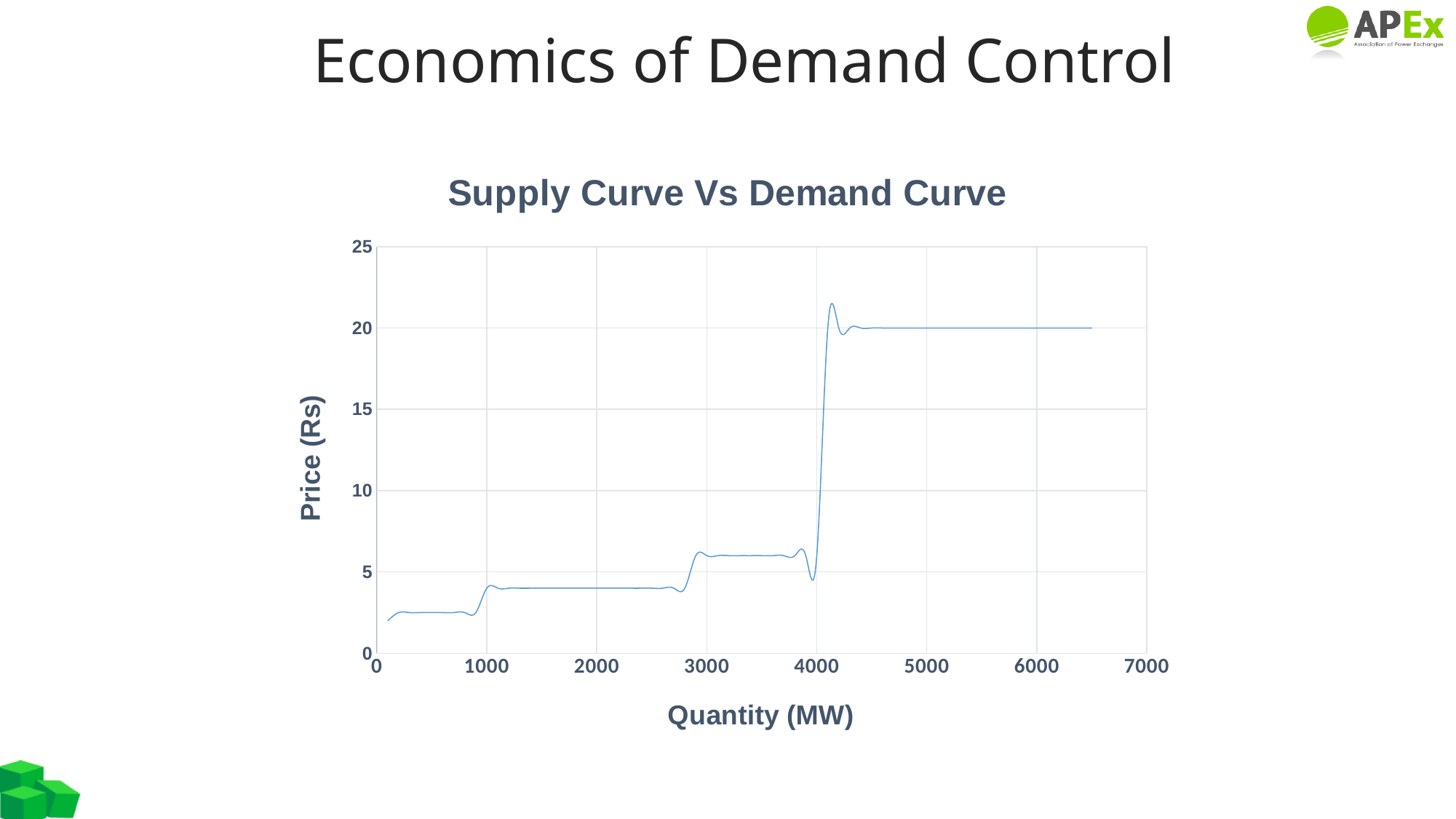
Which is larger, the price at 1500 MW or the price at 3500 MW? the price at 3500 MW What kind of chart is shown on the slide? line chart Is the price at a quantity of 3500 MW greater or less than 10? less Is the price at a quantity of 500 MW greater or less than 5? less Does the price generally rise or fall as quantity increases along the x axis? rise What is the title of the chart? Supply Curve Vs Demand Curve What is the label of the x axis of the chart? Quantity (MW) Which is larger, the price at 5000 MW or the price at 2000 MW? the price at 5000 MW Is the price at a quantity of 5000 MW greater or less than 15? greater